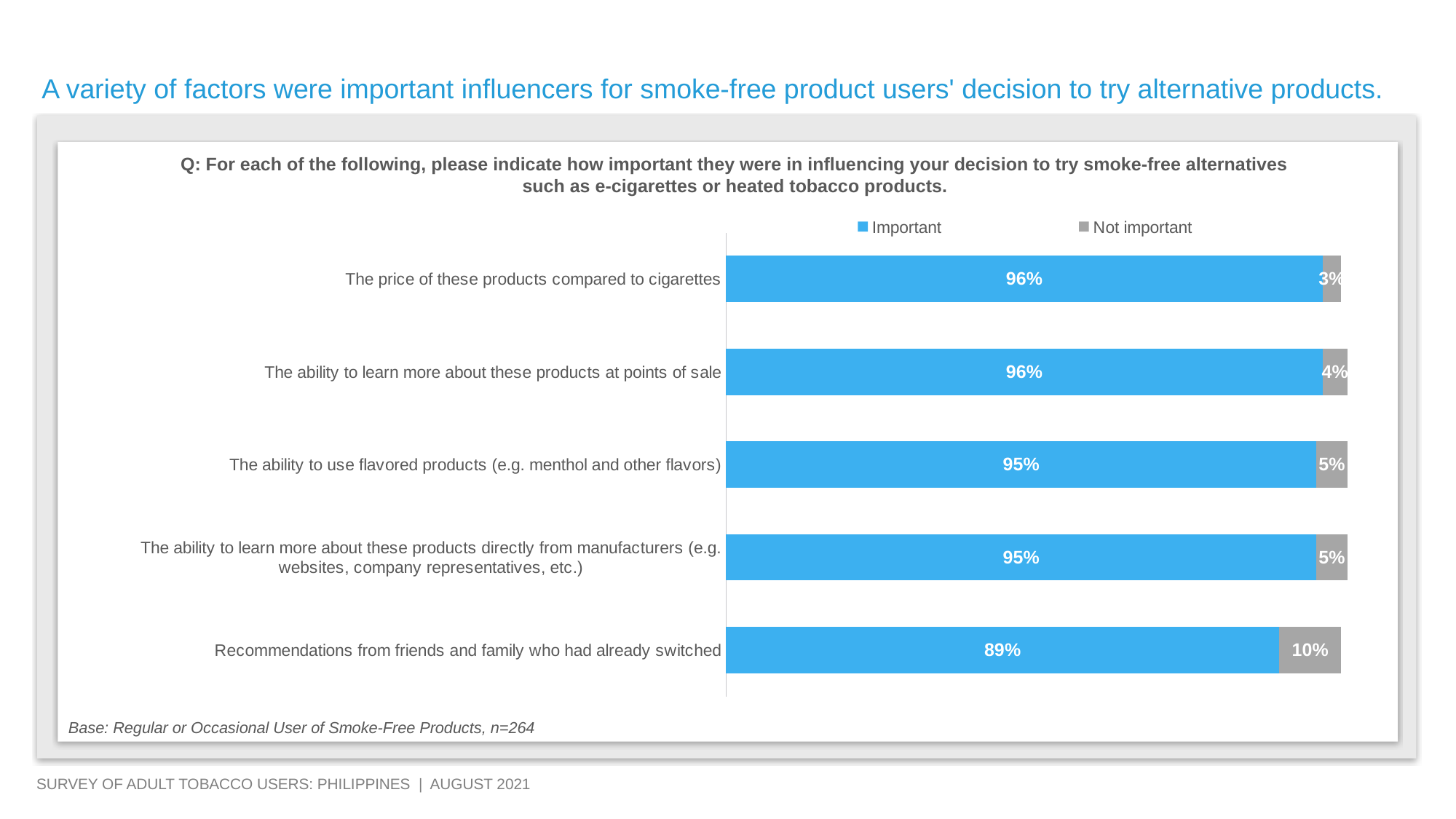
Which is larger: the 'Not important' value for the price of these products compared to cigarettes or for the ability to use flavored products? The ability to use flavored products What is the 'Important' value for the ability to use flavored products (e.g. menthol and other flavors)? 95% What percentage said recommendations from friends and family who had already switched was not important? 10% What percentage of respondents said the price of these products compared to cigarettes was important? 96% What is the 'Not important' value for the ability to learn more about these products at points of sale? 4% What is the difference between the 'Important' percentage for the price of these products compared to cigarettes and for recommendations from friends and family who had already switched? 7 percentage points What type of chart is shown on the slide? Bar chart How many factors are listed in the chart? 5 How many series does the legend list? 2 Which factor has the lowest 'Important' percentage? Recommendations from friends and family who had already switched Which factor has the highest 'Not important' percentage? Recommendations from friends and family who had already switched What colour represents the 'Not important' series in the chart? Grey